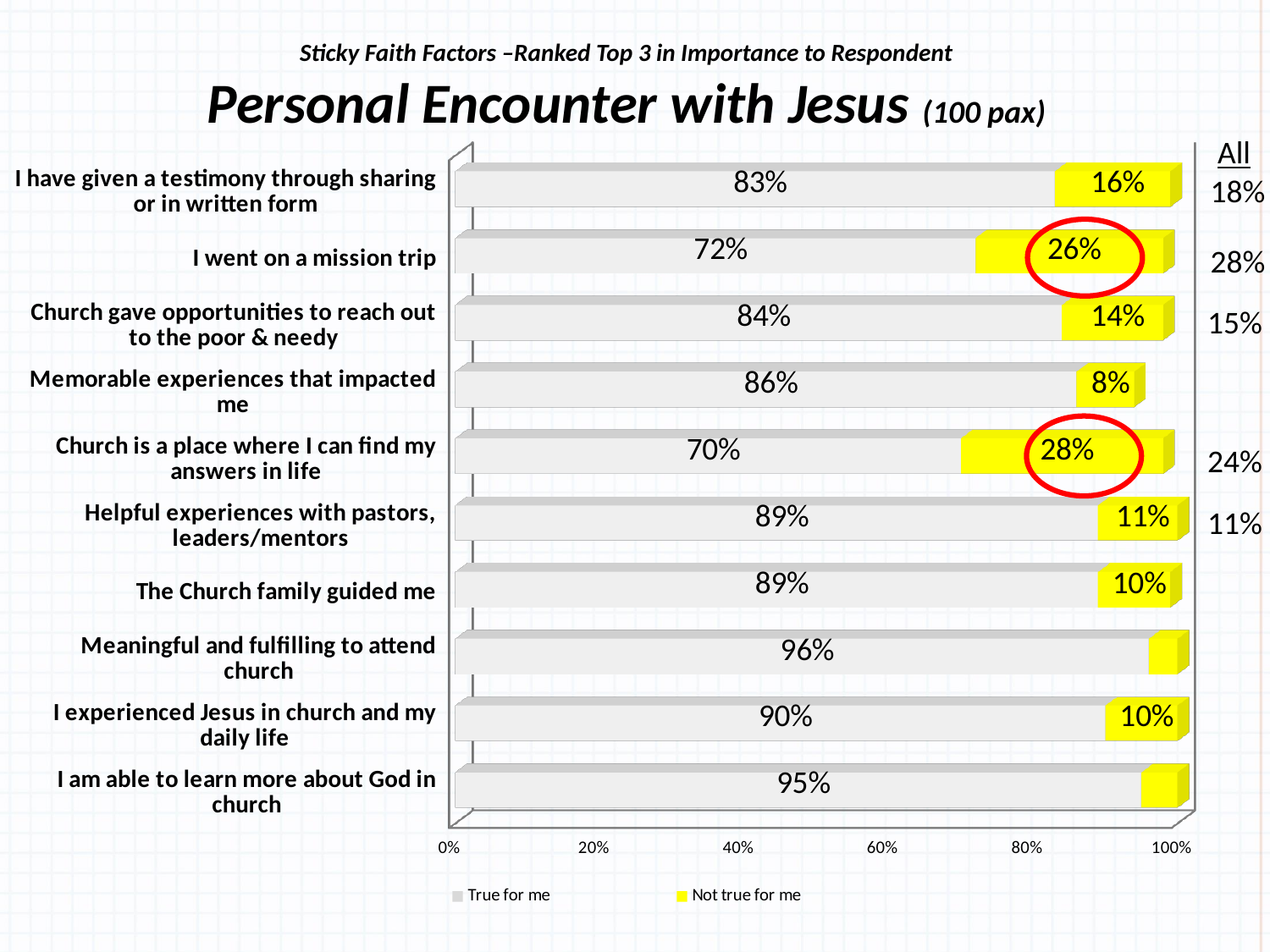
What is the "True for me" value for "Meaningful and fulfilling to attend church"? 96% What is the difference between the "True for me" values for "I experienced Jesus in church and my daily life" and "I went on a mission trip"? 18% How many categories are shown in the chart? 10 What is the "Not true for me" value for "Church is a place where I can find my answers in life"? 28% Which colour represents "Not true for me" in the chart? Yellow Is the "True for me" value for "Memorable experiences that impacted me" greater or less than 80%? greater Which category has the highest "True for me" value? Meaningful and fulfilling to attend church Which category has the lowest "True for me" value? Church is a place where I can find my answers in life What is the "True for me" value for "I went on a mission trip"? 72% Which is larger: the "Not true for me" value for "I went on a mission trip" or for "I have given a testimony through sharing or in written form"? I went on a mission trip How many series does the legend list? 2 What kind of chart is shown on the slide? Stacked bar chart